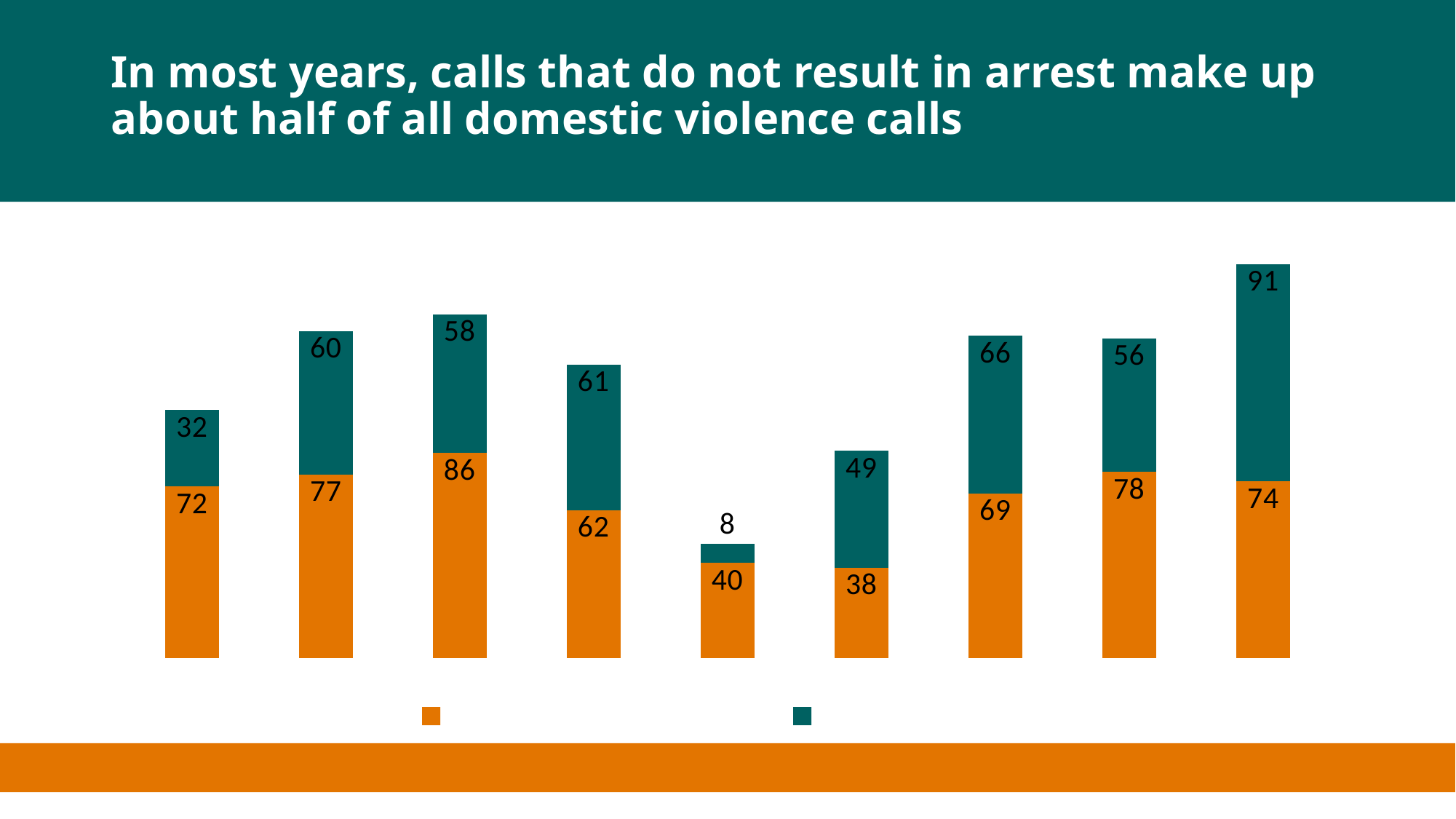
What kind of chart is shown on the slide? stacked bar chart What is the total of the leftmost stacked bar? 104 In the third bar from the left, how much larger is the orange segment than the teal segment? 28 Which bar has the smallest orange segment, and what is its value? The sixth bar from the left, 38 Which is larger: the teal segment of the seventh bar or the teal segment of the eighth bar? The seventh bar (66) How many bars are plotted in the chart? 9 What is the title of the slide? In most years, calls that do not result in arrest make up about half of all domestic violence calls What is the value of the teal segment of the fifth bar from the left? 8 How many series does the legend show? 2 Which bar has the largest teal segment, and what is its value? The rightmost (ninth) bar, 91 What is the value of the orange segment of the leftmost bar? 72 What is the total of the rightmost stacked bar? 165